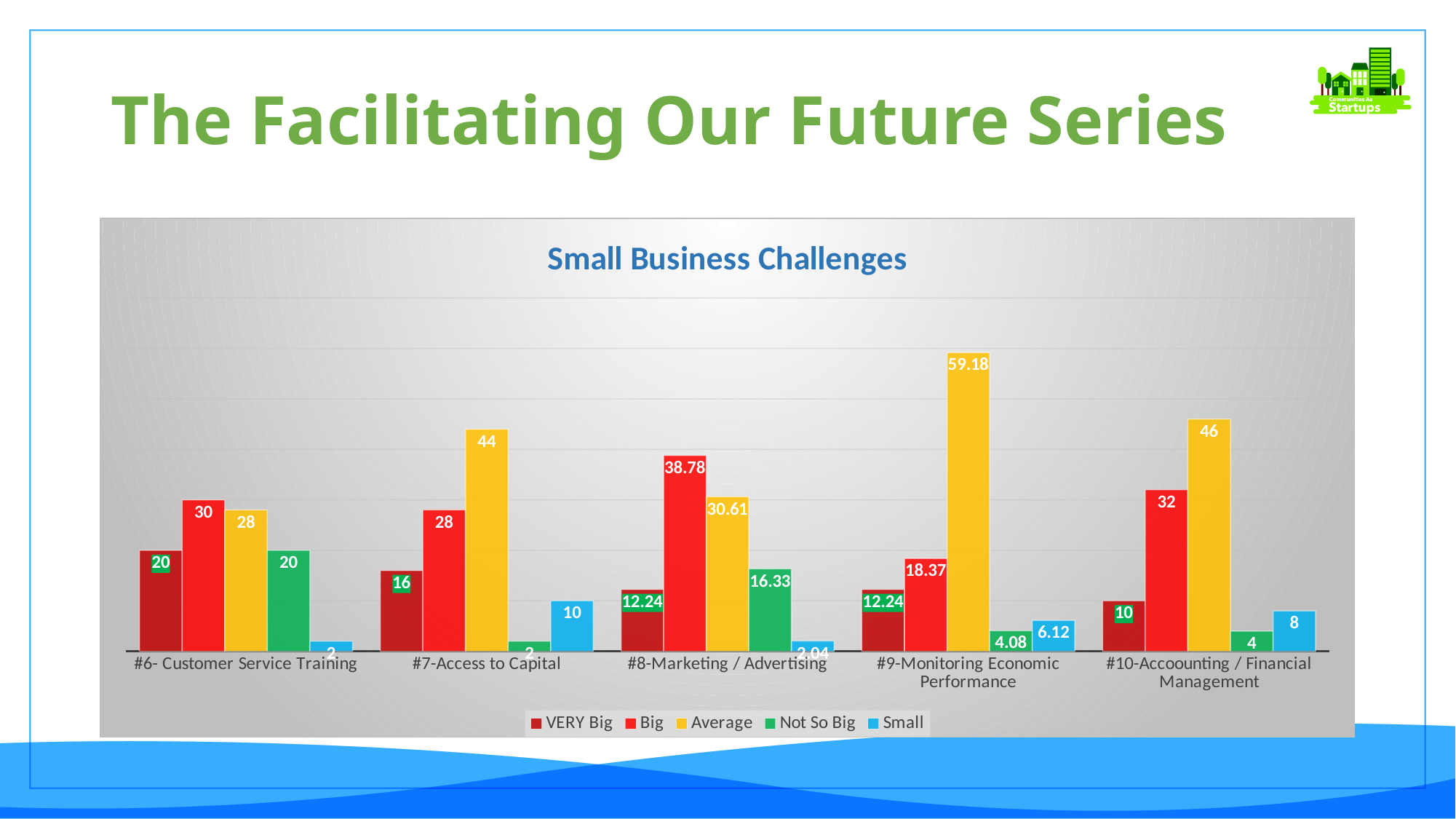
What is the Not So Big value for #8-Marketing / Advertising? 16.33 What is the difference between the Average value and the Big value for #10-Accoounting / Financial Management? 14 Which category has the highest Average value? #9-Monitoring Economic Performance What is the Small value for #7-Access to Capital? 10 What is the Average value for #9-Monitoring Economic Performance? 59.18 Which is larger for #6- Customer Service Training, the Big value or the Average value? Big Which category has the lowest Small value? #6- Customer Service Training What type of chart is shown on the slide? Bar chart How many categories are shown on the x axis? 5 What is the title of the chart? Small Business Challenges What is the Big value for #8-Marketing / Advertising? 38.78 How many series does the legend list? 5